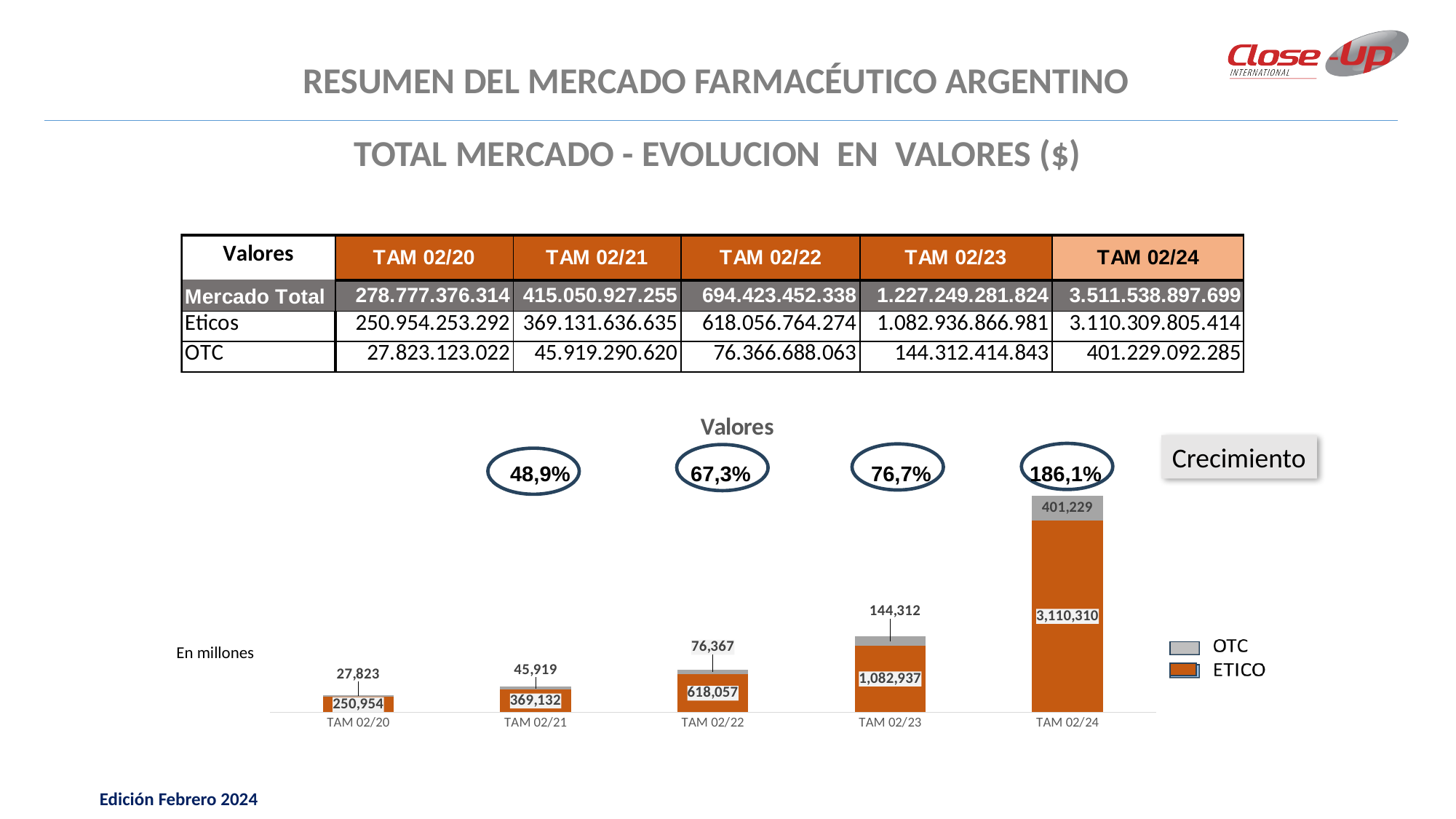
What is the ETICO value for TAM 02/24 in the chart? 3,110,310 What is the ETICO value for TAM 02/20 in the chart? 250,954 What is the difference between the OTC values for TAM 02/24 and TAM 02/23 in the chart? 256,917 Which TAM period has the highest OTC value in the chart? TAM 02/24 What type of chart is shown on the slide? Stacked bar chart What is the OTC value for TAM 02/22 in the chart? 76,367 How many TAM periods are plotted on the x axis of the chart? 5 How many series does the chart legend list? 2 Do the ETICO values rise or fall from TAM 02/20 to TAM 02/24 in the chart? Rise Which is larger in the chart: the ETICO value for TAM 02/22 or the ETICO value for TAM 02/21? ETICO value for TAM 02/22 Which TAM period has the lowest ETICO value in the chart? TAM 02/20 What is the total of the stacked bar for TAM 02/23 in the chart? 1,227,249